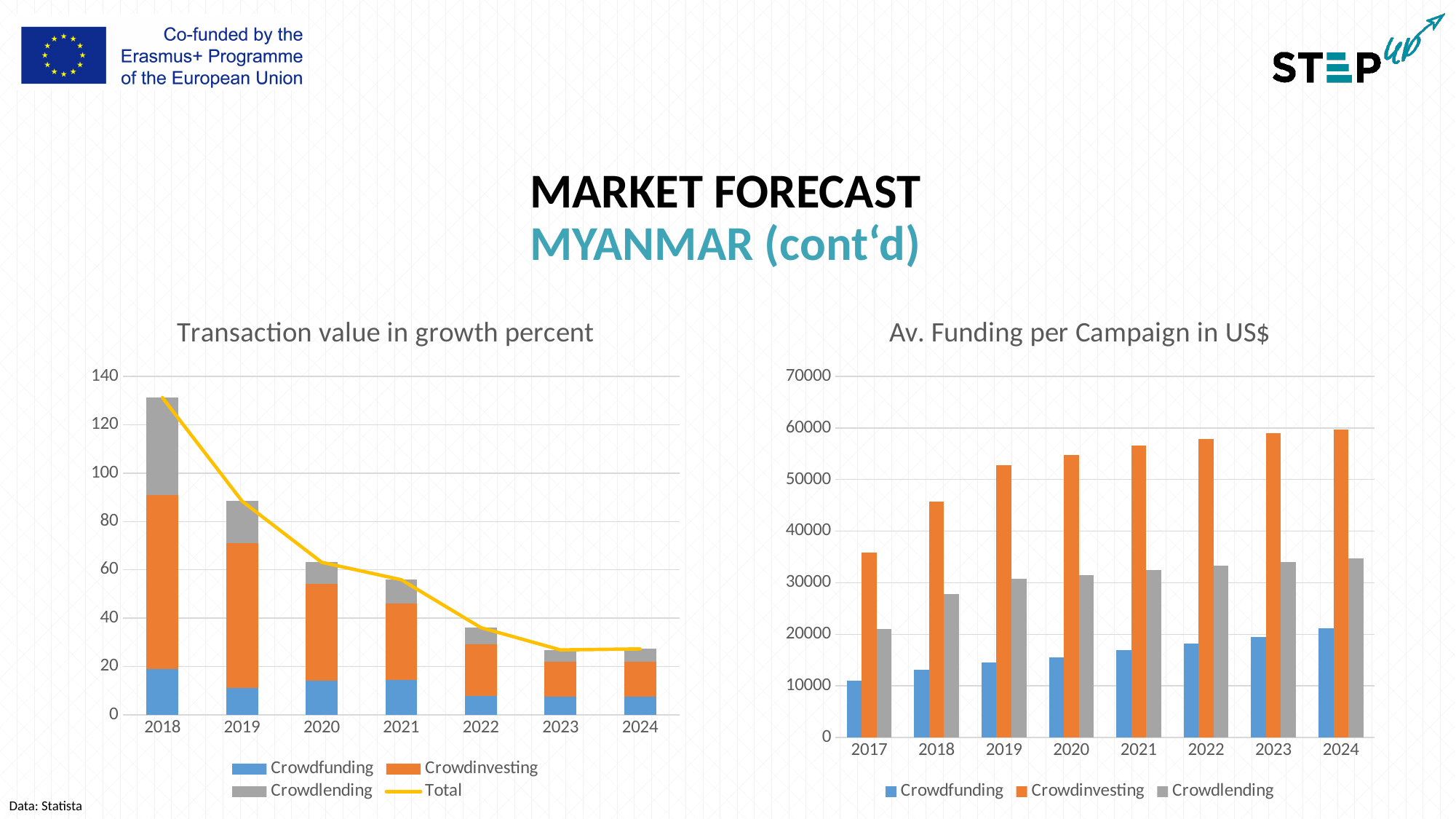
In the 'Transaction value in growth percent' chart, does the Total line rise or fall from 2018 to 2023? fall In the 'Transaction value in growth percent' chart, which year has the highest Total? 2018 What type of chart is the 'Transaction value in growth percent' chart? bar chart with a line How many series does the legend of the 'Av. Funding per Campaign in US$' chart list? 3 What type of chart is the 'Av. Funding per Campaign in US$' chart? bar chart How many years are shown on the x axis of the 'Transaction value in growth percent' chart? 7 How many years are shown on the x axis of the 'Av. Funding per Campaign in US$' chart? 8 In the 'Av. Funding per Campaign in US$' chart, which is larger in 2019: Crowdfunding or Crowdlending? Crowdlending In the 'Transaction value in growth percent' chart, is the Total for 2018 greater or less than 120? greater In the 'Av. Funding per Campaign in US$' chart, which series has the highest value in 2024? Crowdinvesting How many series does the legend of the 'Transaction value in growth percent' chart list? 4 In the 'Av. Funding per Campaign in US$' chart, is the Crowdinvesting value for 2017 greater or less than 40000? less